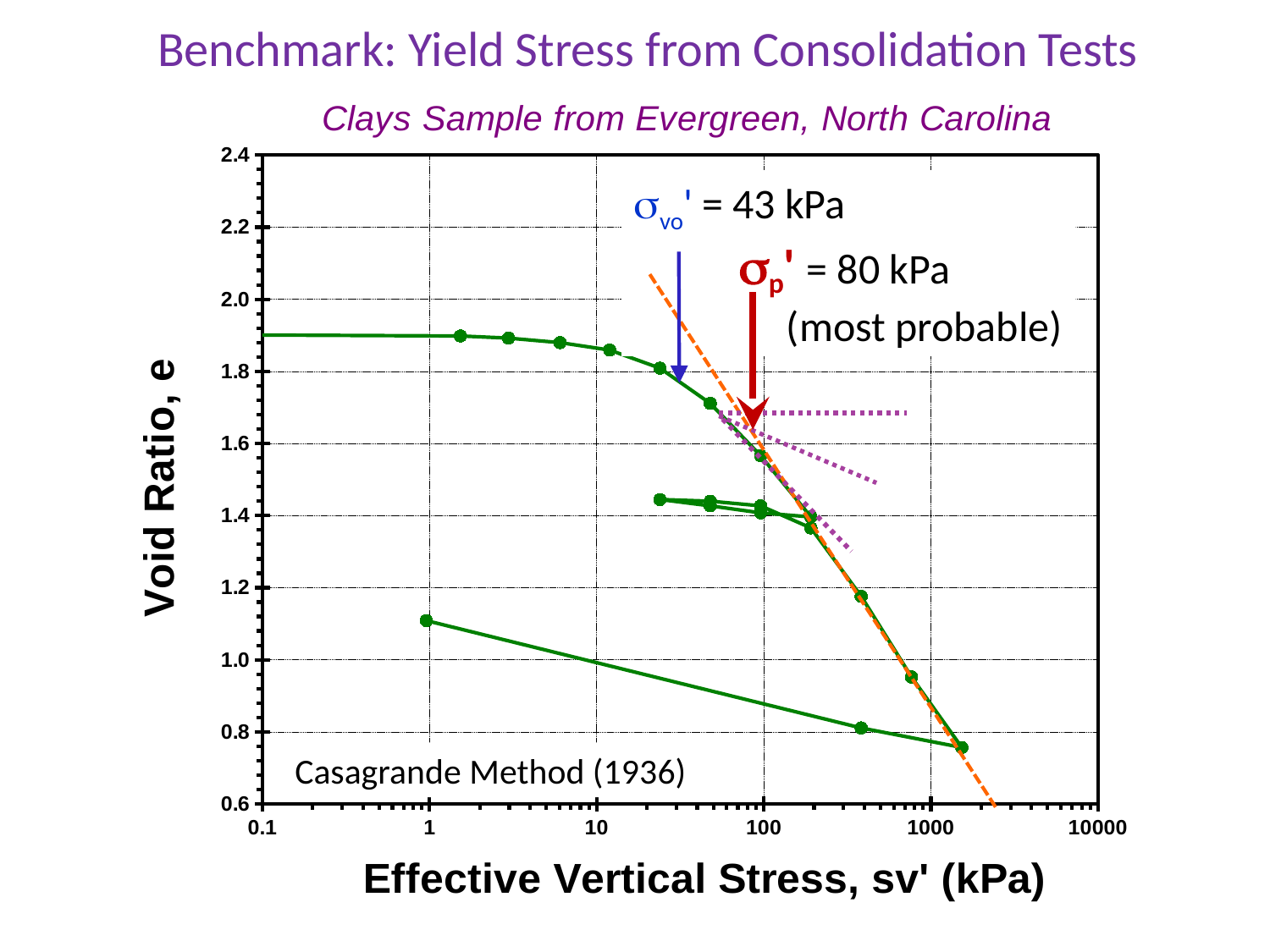
Is the void ratio of the first data point on the main curve (near 1 kPa) greater or less than 1.8? greater As effective vertical stress increases along the x axis, does the void ratio of the main curve rise or fall? fall What value is given for σvo' on the chart? 43 kPa What kind of chart is shown on the slide? line chart What is the label of the y axis? Void Ratio, e Is the void ratio of the lower line's point at about 1 kPa greater or less than 1.0? greater What is the difference between the annotated σp' and σvo' values? 37 kPa Is the void ratio of the main curve at about 200 kPa greater or less than 1.6? less Which is larger, the annotated σp' or the annotated σvo'? σp' Which method is named in the lower-left corner of the chart? Casagrande Method (1936) What is the most probable yield stress σp' annotated on the chart? 80 kPa